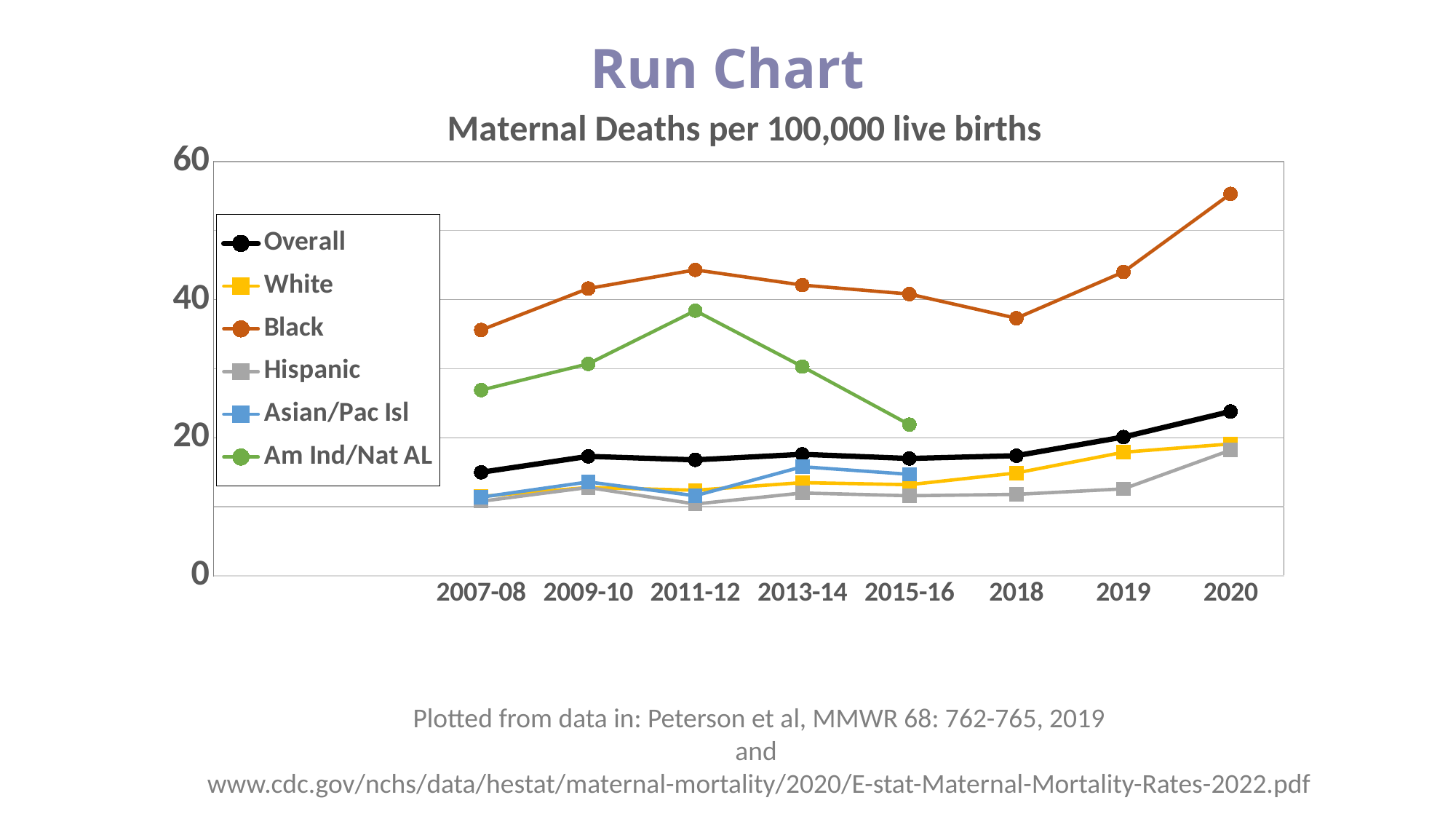
Is the value for Overall in 2020 greater or less than 20? greater Is the value for Hispanic in 2011-12 greater or less than 20? less Which series has the highest value in 2020? Black Is the value for Black in 2018 greater or less than 40? less What kind of chart is shown on the slide? line chart Does the Black series rise or fall from 2018 to 2020? rise How many series does the legend list? 6 Which series has the highest value in 2011-12? Black What is the title of the chart? Maternal Deaths per 100,000 live births How many time periods are shown on the x axis? 8 Which is larger for Am Ind/Nat AL: the value in 2011-12 or the value in 2015-16? 2011-12